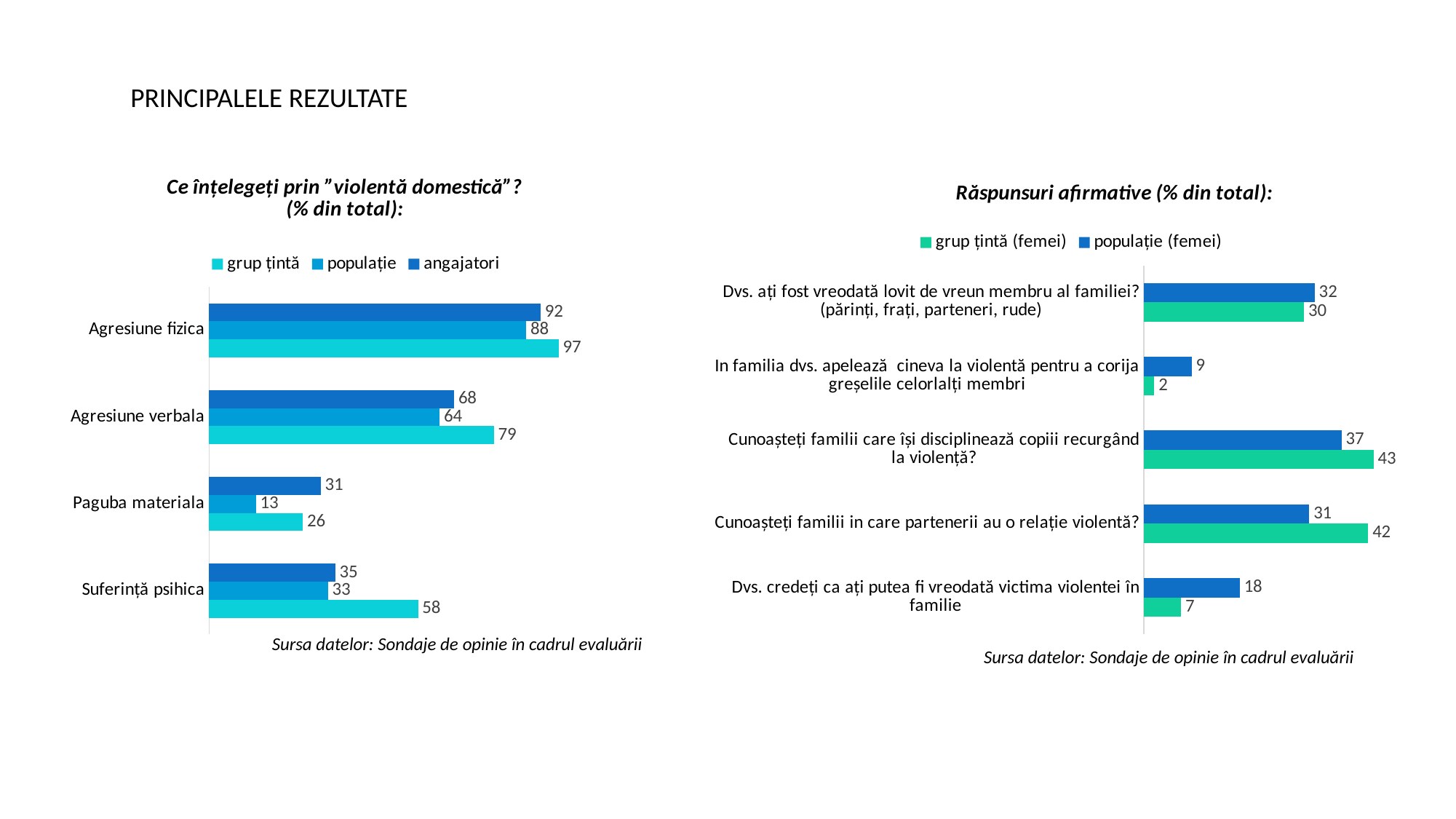
In the right chart (Răspunsuri afirmative), what is the difference between populație (femei) and grup țintă (femei) for "Dvs. ați fost vreodată lovit de vreun membru al familiei?"? 2 In the left chart (Ce înțelegeți prin "violentă domestică"?), what is the difference between the grup țintă and populație values for Suferință psihica? 25 In the left chart (Ce înțelegeți prin "violentă domestică"?), how many categories are shown? 4 In the left chart (Ce înțelegeți prin "violentă domestică"?), what is the value for populație for Paguba materiala? 13 In the right chart (Răspunsuri afirmative), which question has the lowest value for grup țintă (femei)? In familia dvs. apelează cineva la violentă pentru a corija greșelile celorlalți membri In the right chart (Răspunsuri afirmative), which is larger for "Cunoașteți familii in care partenerii au o relație violentă?": grup țintă (femei) or populație (femei)? grup țintă (femei) What kind of chart is the right chart (Răspunsuri afirmative)? Bar chart In the left chart (Ce înțelegeți prin "violentă domestică"?), what is the value for grup țintă for Agresiune fizica? 97 In the left chart (Ce înțelegeți prin "violentă domestică"?), which category has the highest value for angajatori? Agresiune fizica In the right chart (Răspunsuri afirmative), what is the value for populație (femei) for "Dvs. credeți ca ați putea fi vreodată victima violentei în familie"? 18 In the left chart (Ce înțelegeți prin "violentă domestică"?), how many series does the legend list? 3 In the right chart (Răspunsuri afirmative), what is the value for grup țintă (femei) for "Cunoașteți familii care își disciplinează copiii recurgând la violență?"? 43